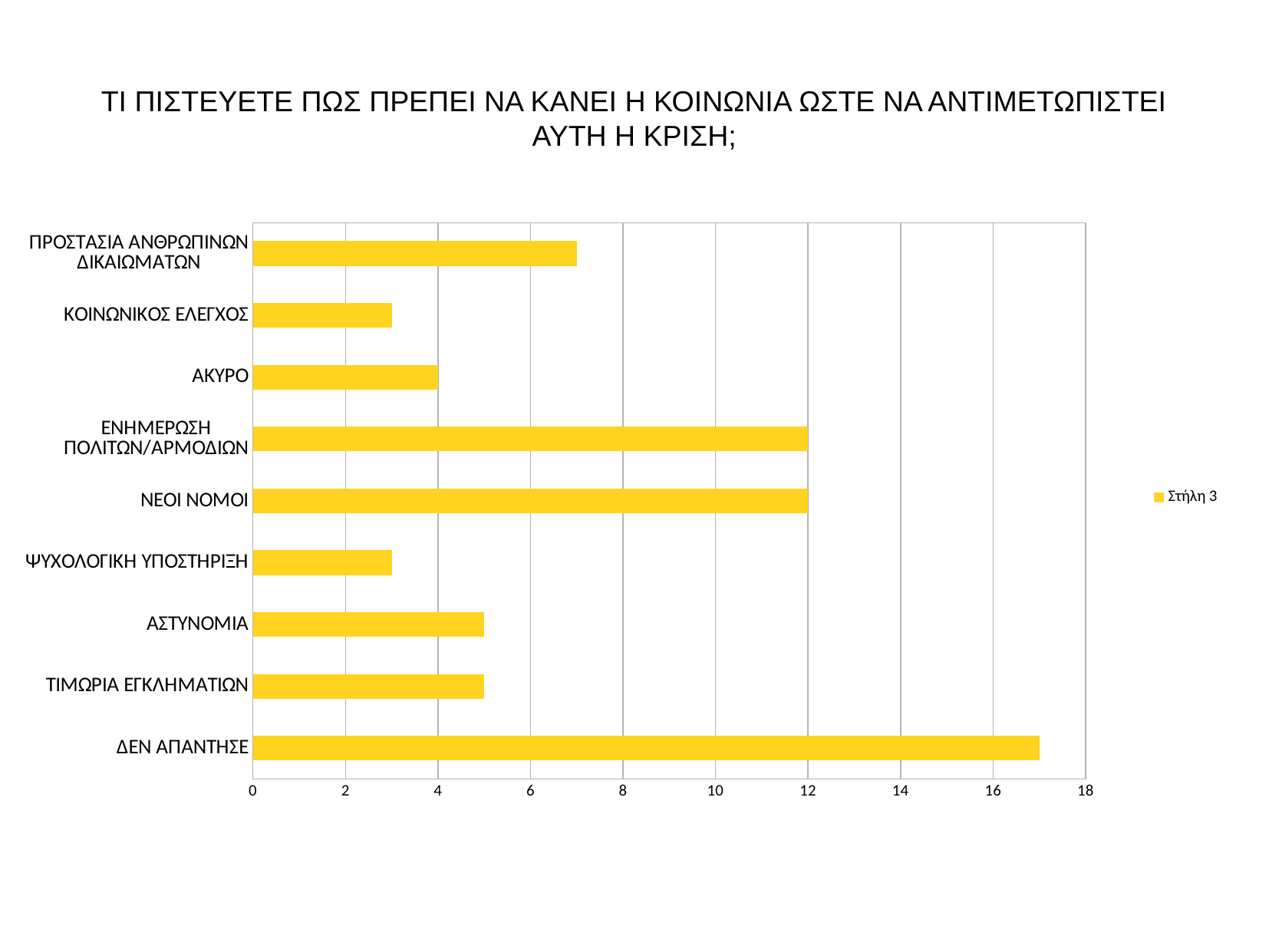
What is the value for ΕΝΗΜΕΡΩΣΗ ΠΟΛΙΤΩΝ/ΑΡΜΟΔΙΩΝ? 12 What is the value for ΝΕΟΙ ΝΟΜΟΙ? 12 What is the value for ΑΚΥΡΟ? 4 What is the difference between the values for ΝΕΟΙ ΝΟΜΟΙ and ΑΚΥΡΟ? 8 What is the name of the series shown in the legend? Στήλη 3 What kind of chart is shown on the slide? Bar chart Which is larger, the value for ΠΡΟΣΤΑΣΙΑ ΑΝΘΡΩΠΙΝΩΝ ΔΙΚΑΙΩΜΑΤΩΝ or the value for ΑΣΤΥΝΟΜΙΑ? ΠΡΟΣΤΑΣΙΑ ΑΝΘΡΩΠΙΝΩΝ ΔΙΚΑΙΩΜΑΤΩΝ Which category has the highest value? ΔΕΝ ΑΠΑΝΤΗΣΕ Is the value for ΔΕΝ ΑΠΑΝΤΗΣΕ greater or less than 16? greater Is the value for ΚΟΙΝΩΝΙΚΟΣ ΕΛΕΓΧΟΣ greater or less than 4? less How many series does the legend list? 1 How many categories are plotted on the chart? 9